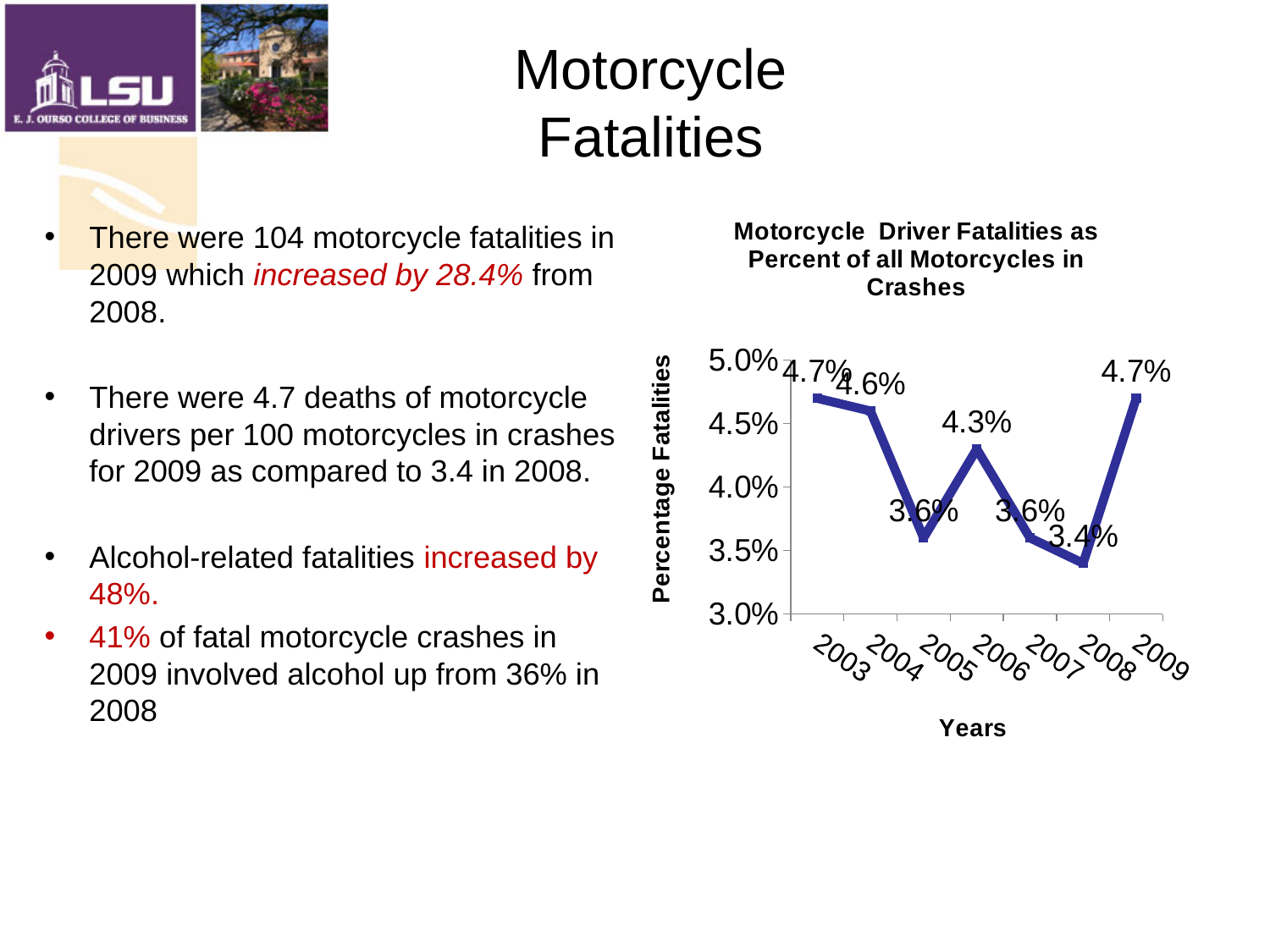
What is the label on the x axis of the chart? Years Which year has a higher percentage of motorcycle driver fatalities, 2006 or 2007? 2006 How many years are plotted on the chart? 7 What is the difference between the percentage in 2009 and the percentage in 2008? 1.3% Is the value for 2005 greater or less than 4.0%? less What kind of chart is shown on the slide? line chart What is the percentage of motorcycle driver fatalities in 2009? 4.7% Which year has the lowest percentage of motorcycle driver fatalities? 2008 Does the percentage rise or fall from 2008 to 2009? rise What is the percentage of motorcycle driver fatalities in 2006? 4.3% What is the percentage of motorcycle driver fatalities in 2008? 3.4% What is the percentage of motorcycle driver fatalities in 2004? 4.6%